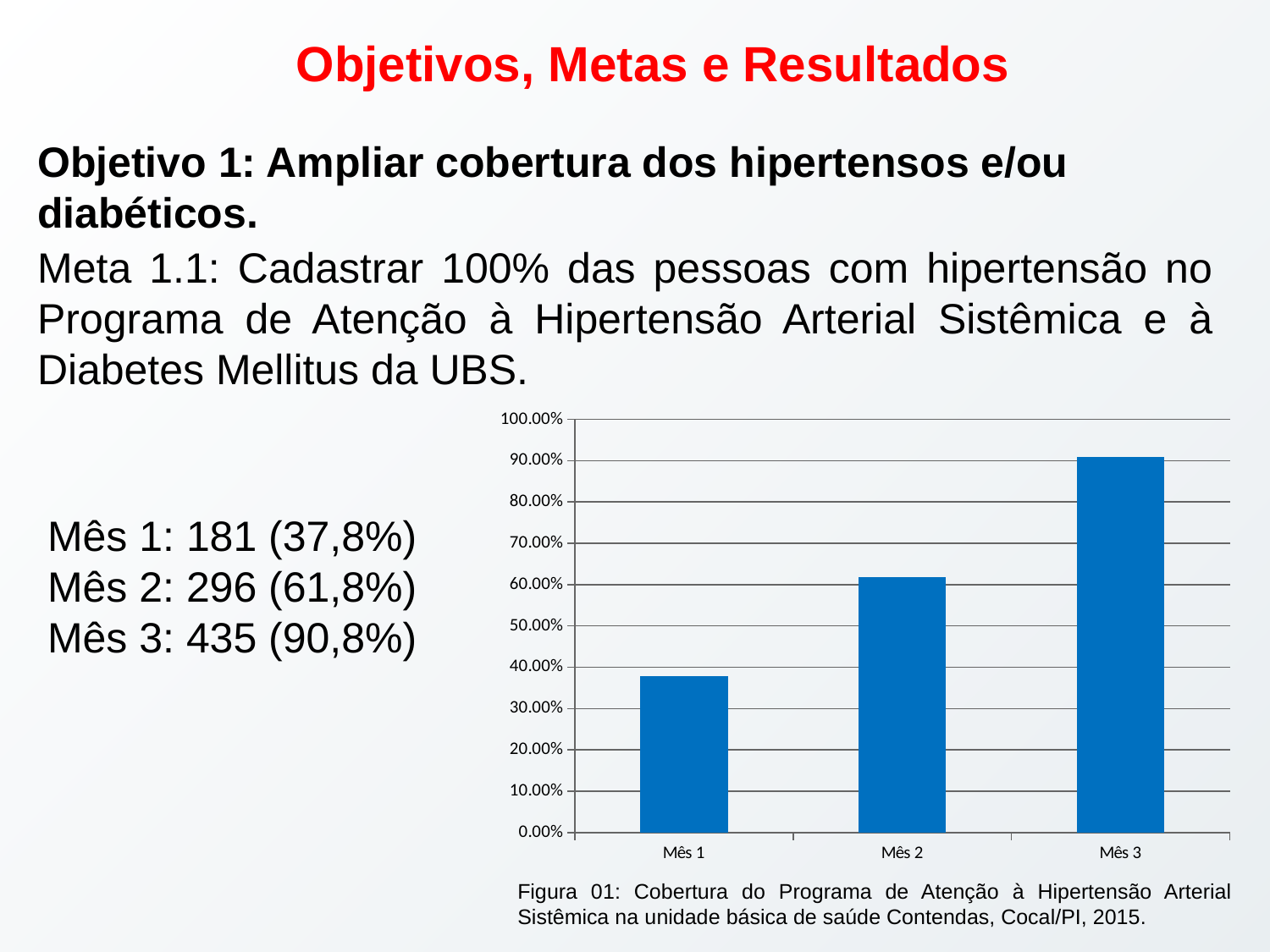
According to the slide, what coverage percentage corresponds to Mês 1? 37,8% Do the values rise or fall from Mês 1 to Mês 3? rise What is the maximum value shown on the chart's vertical axis? 100.00% According to the slide, what coverage percentage corresponds to Mês 3? 90,8% Is the value for Mês 3 greater or less than 90.00%? greater Which month has the lowest coverage in the chart? Mês 1 Which month has the highest coverage in the chart? Mês 3 What kind of chart is shown on the slide? bar chart Which is larger, the value for Mês 2 or the value for Mês 3? Mês 3 Is the value for Mês 2 greater or less than 60.00%? greater How many bars (months) does the chart show? 3 Is the value for Mês 1 greater or less than 40.00%? less